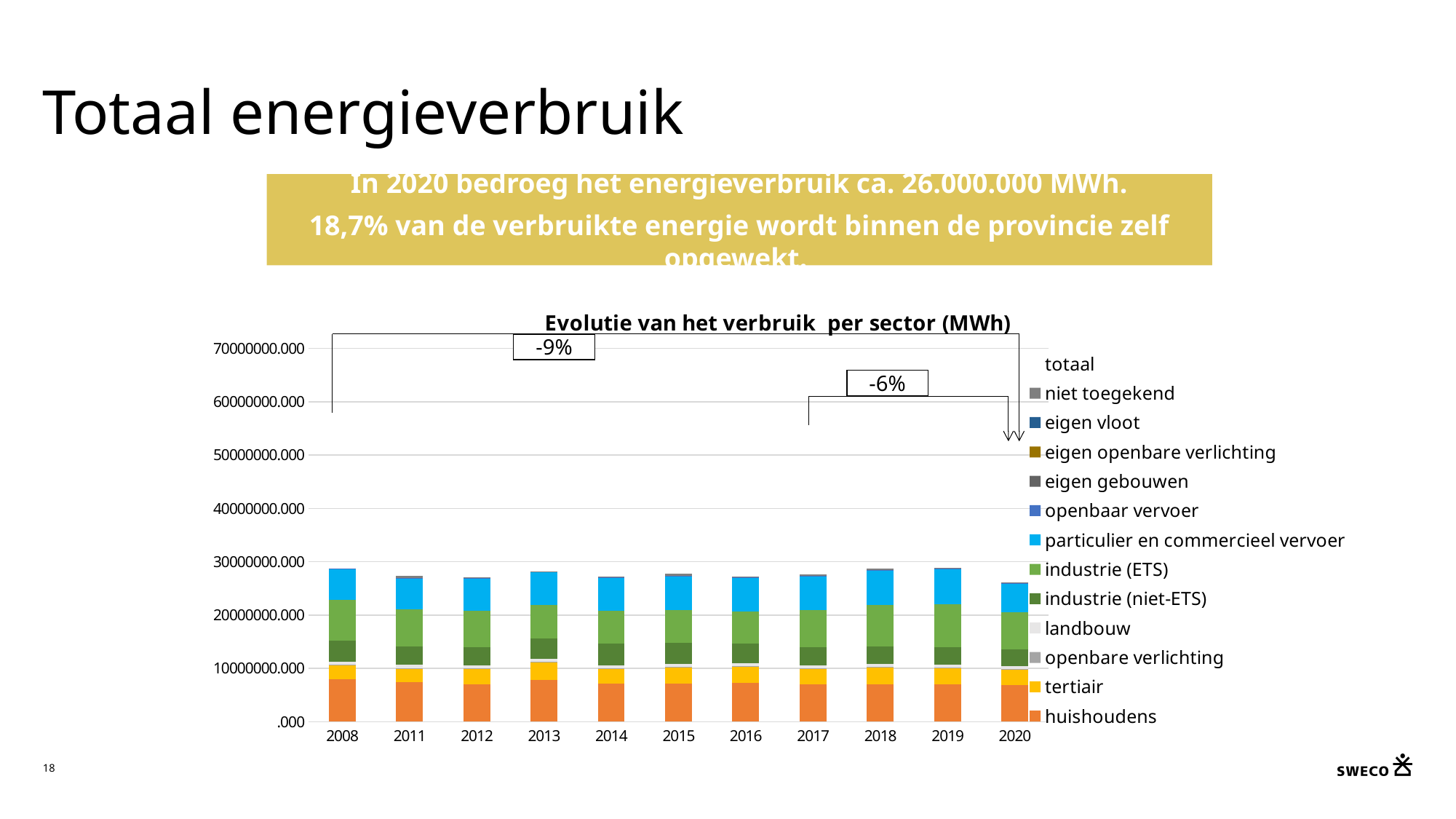
What is the title of the chart? Evolutie van het verbruik per sector (MWh) Is the total bar for 2008 greater or less than 20000000.000? greater How many years are shown on the x axis of the chart? 11 What kind of chart is shown on the slide? Stacked bar chart Which year has the lowest total bar? 2020 Is the total bar for 2020 greater or less than 30000000.000? less Does the total energy consumption rise or fall from 2008 to 2020? Fall Is the huishoudens segment for 2008 greater or less than 10000000.000? less How many entries does the chart legend list? 13 Which year has a higher total bar, 2008 or 2020? 2008 What percentage change is annotated between 2008 and 2020 on the chart? -9% Which legend entry is shown at the bottom of each stacked bar? huishoudens